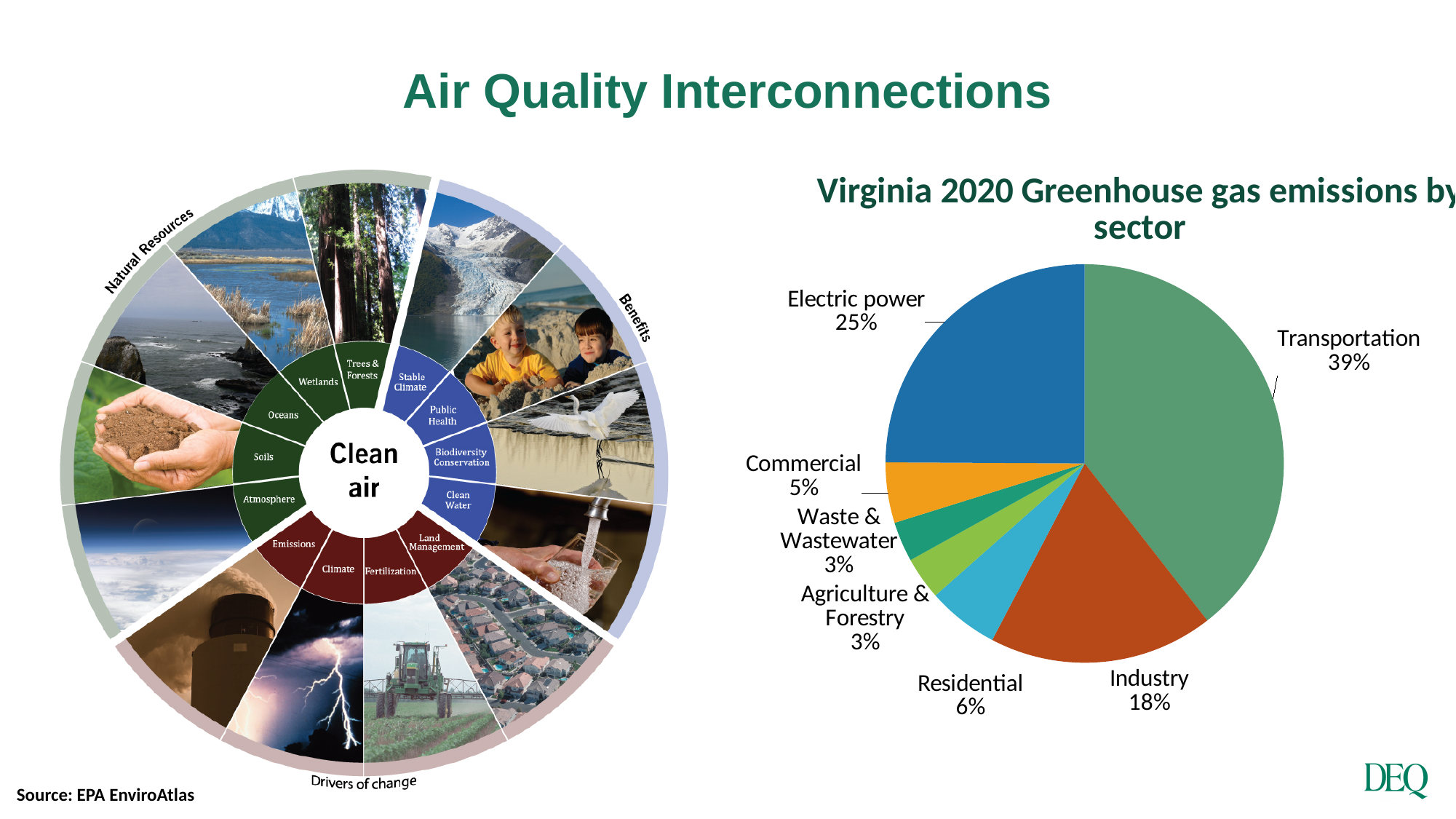
What is the title of the pie chart? Virginia 2020 Greenhouse gas emissions by sector What type of chart is used to show Virginia 2020 greenhouse gas emissions by sector? Pie chart What is the difference in percentage points between Transportation and Electric power? 14 percentage points Which sector has a larger share, Commercial or Residential? Residential What percentage of emissions is attributed to Electric power in the pie chart? 25% What is the combined share of Electric power and Industry? 43% How many sectors are shown in the pie chart? 7 What share of Virginia's 2020 greenhouse gas emissions came from Transportation? 39% Which sector has the largest share of Virginia's 2020 greenhouse gas emissions? Transportation What is the value shown for Industry in the pie chart? 18% Which sector has the smallest share in the pie chart? Waste & Wastewater and Agriculture & Forestry (3% each) What percentage does the Residential sector account for? 6%